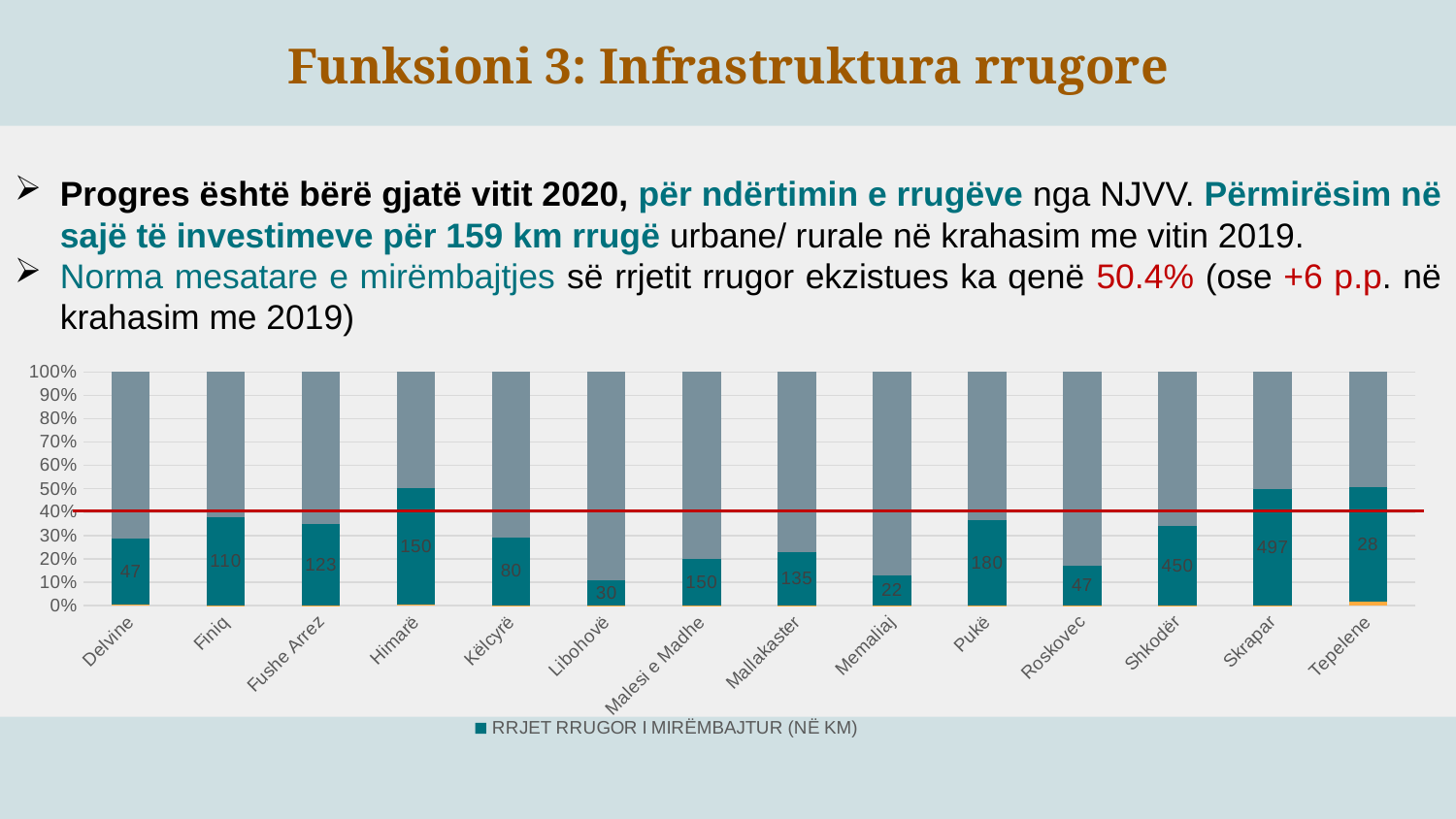
What is the difference between the labelled values for Skrapar and Shkodër? 47 Which municipality has the highest labelled value for maintained road network (in km)? Skrapar Is the teal (maintained) share for Himarë greater or less than 40%? greater Which municipality has the lowest labelled value for maintained road network (in km)? Memaliaj What is the data label shown for Shkodër? 450 What is the data label shown for Skrapar? 497 What is the data label shown for Memaliaj? 22 Is the teal (maintained) share for Libohovë greater or less than 20%? less What is the data label shown for Pukë? 180 Which has a larger labelled value, Finiq or Fushe Arrez? Fushe Arrez What kind of chart is shown on the slide? Stacked bar chart How many municipalities are shown on the x axis of the chart? 14